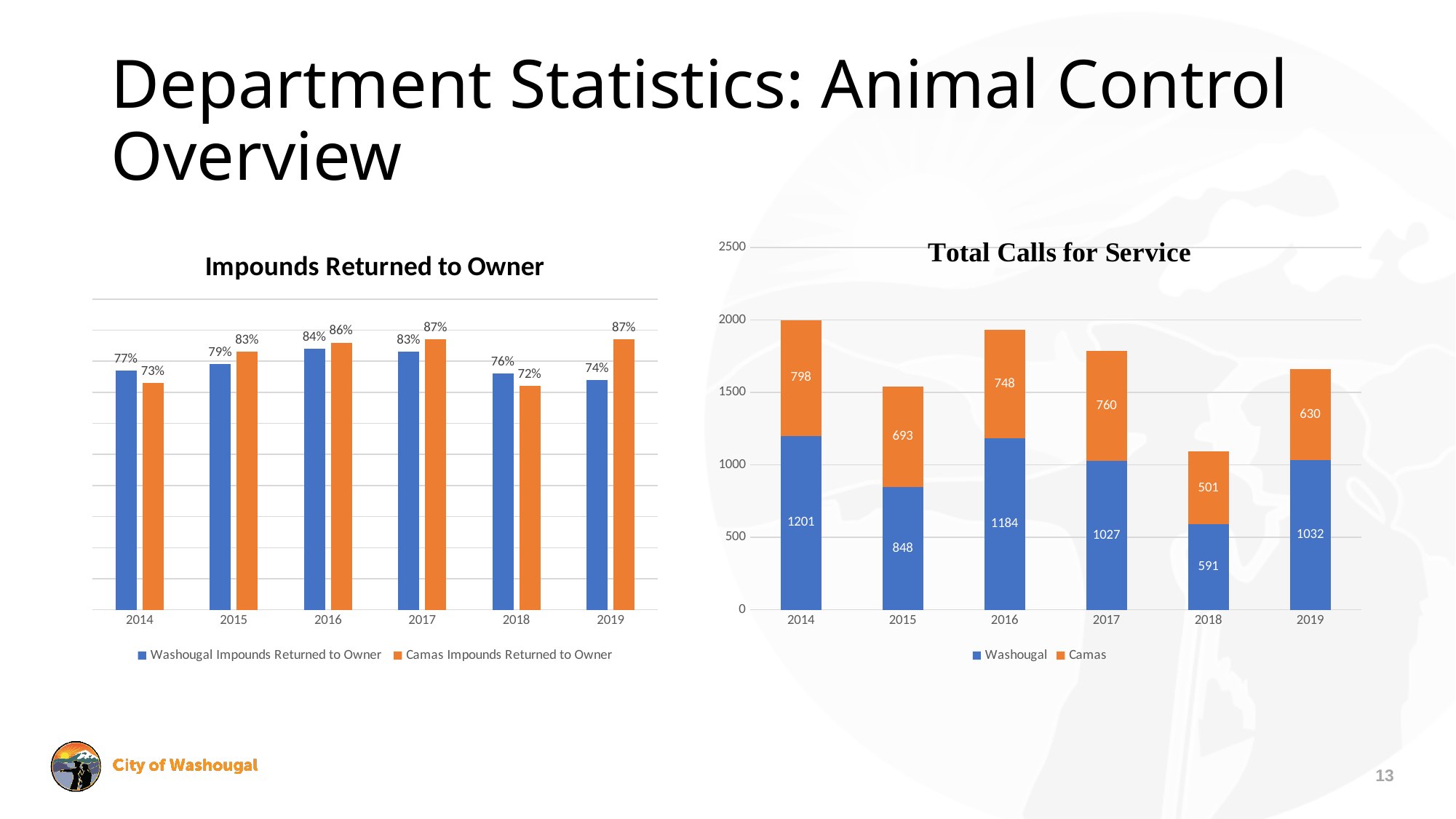
In the Impounds Returned to Owner chart, what is the difference between the Camas and Washougal values in 2019? 13% In the Total Calls for Service chart, what is the total of the stacked bar for 2015? 1541 In the Total Calls for Service chart, what is the Camas value for 2014? 798 What kind of chart is the Total Calls for Service chart? Stacked bar chart In the Impounds Returned to Owner chart, which year has the lowest Washougal value? 2019 In the Impounds Returned to Owner chart, which is larger in 2014, the Washougal value or the Camas value? Washougal In the Total Calls for Service chart, which year has the highest Washougal value? 2014 How many series does the legend of the Impounds Returned to Owner chart list? 2 In the Impounds Returned to Owner chart, what is the value for Camas in 2018? 72% In the Impounds Returned to Owner chart, what is the value for Washougal in 2016? 84% In the Total Calls for Service chart, what is the Washougal value for 2018? 591 In the Total Calls for Service chart, what is the difference between the Washougal values for 2016 and 2017? 157